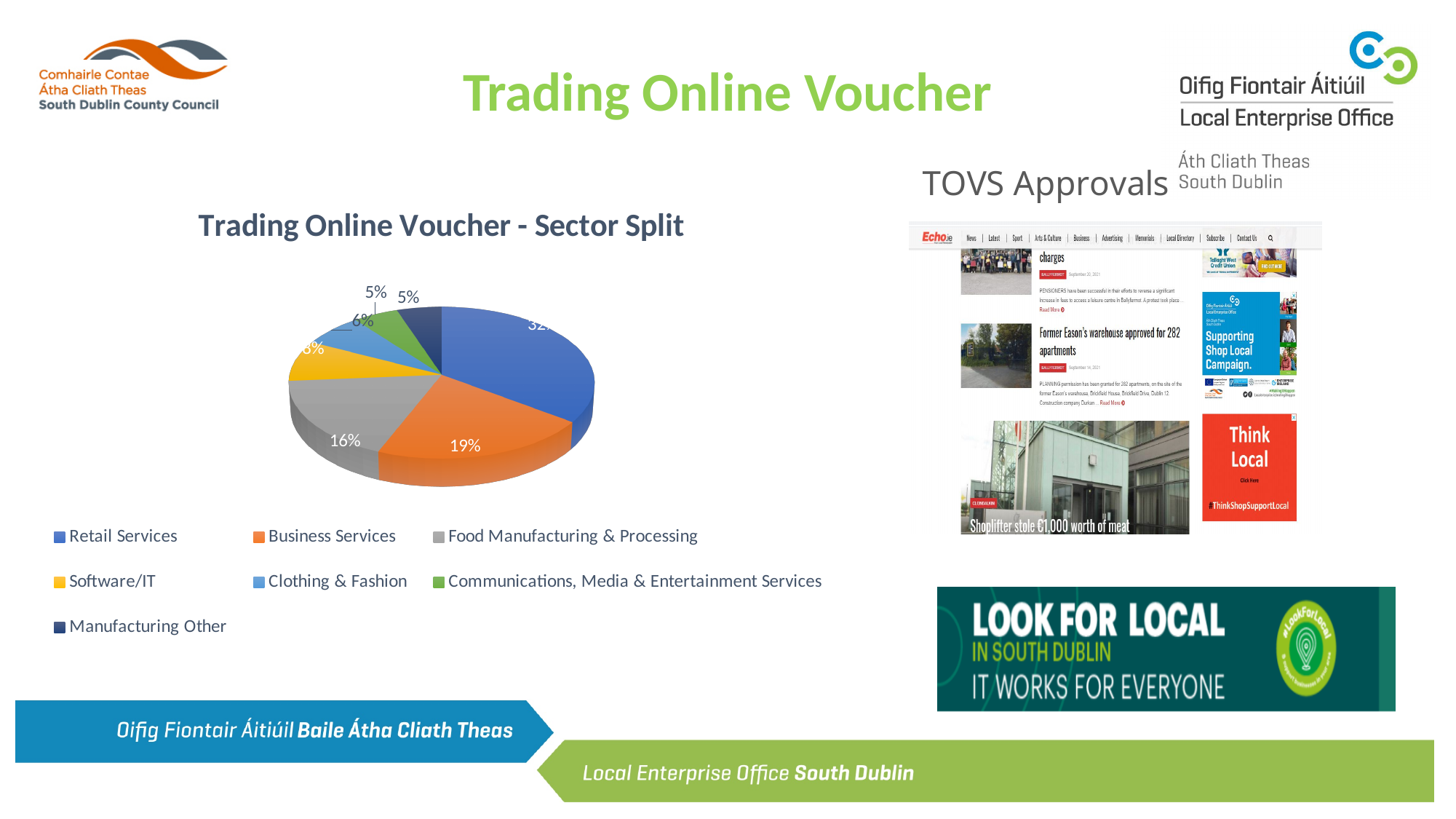
What percentage is shown for Clothing & Fashion? 6% How many sectors does the legend of the Sector Split chart list? 7 Which is larger, the share for Business Services or for Food Manufacturing & Processing? Business Services What share of the Trading Online Voucher sector split is Business Services? 19% What share of the pie is Food Manufacturing & Processing? 16% What percentage is shown for Communications, Media & Entertainment Services? 5% Which sector has the largest slice of the pie? Retail Services What colour represents Software/IT in the pie chart? Yellow By how many percentage points does Business Services exceed Food Manufacturing & Processing? 3 percentage points What is the title of the pie chart? Trading Online Voucher - Sector Split What kind of chart is shown on the slide? Pie chart What percentage is shown for Manufacturing Other? 5%